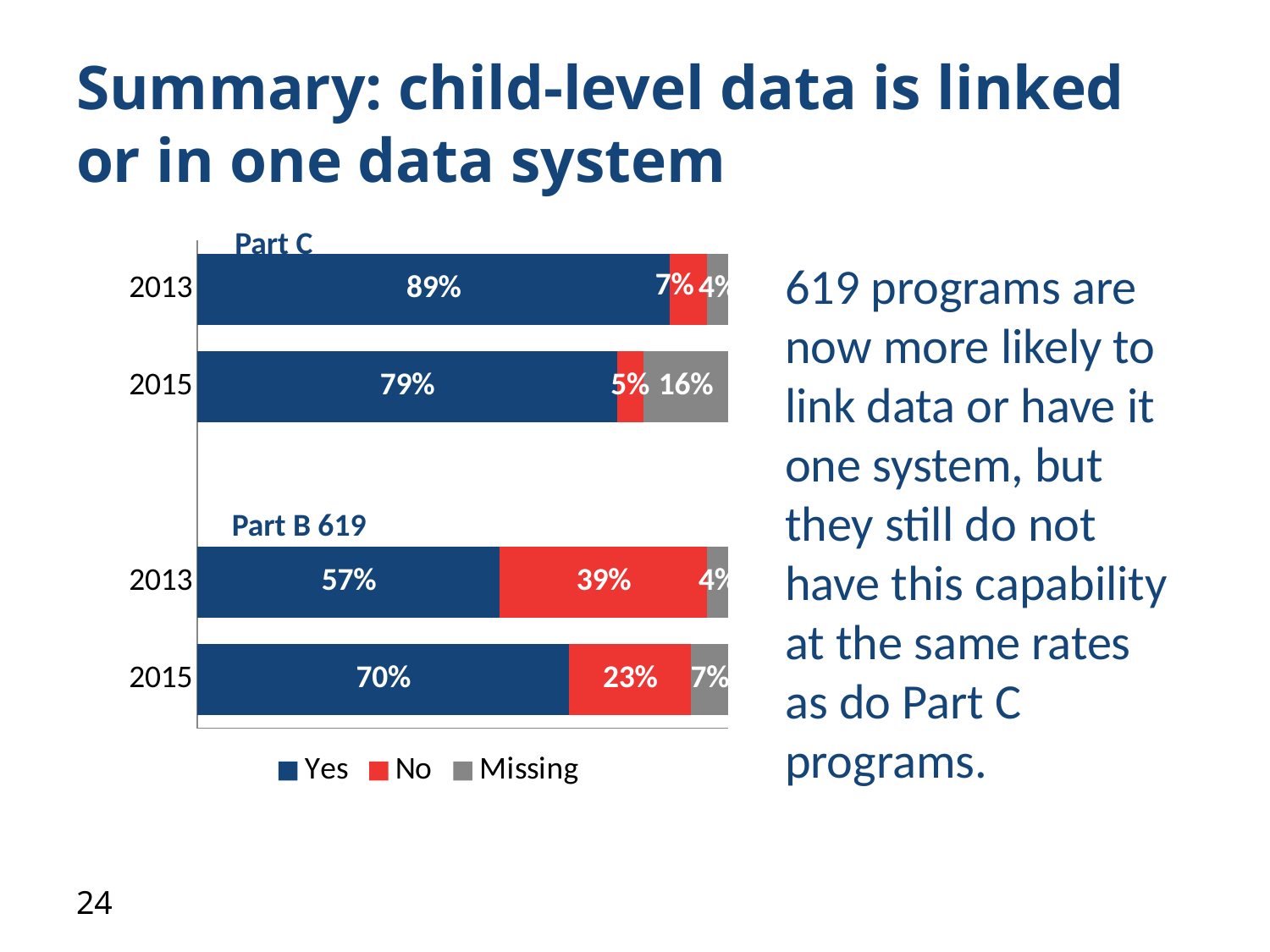
How many bars are shown in the chart? 4 What is the Missing percentage for Part C in 2015? 16% Which is larger: the No percentage for Part C in 2013 or the No percentage for Part B 619 in 2015? Part B 619 in 2015 Which bar has the highest Yes percentage? Part C 2013 What percentage of Part B 619 programs answered Yes in 2015? 70% By how many percentage points did the Yes share for Part B 619 change from 2013 to 2015? 13 percentage points What percentage of Part C programs answered Yes in 2013? 89% What kind of chart is shown on the slide? Stacked bar chart Which bar has the lowest Yes percentage? Part B 619 2013 Which colour represents the Missing category in the chart? Gray How many series does the legend list? 3 What percentage of Part B 619 programs answered No in 2013? 39%